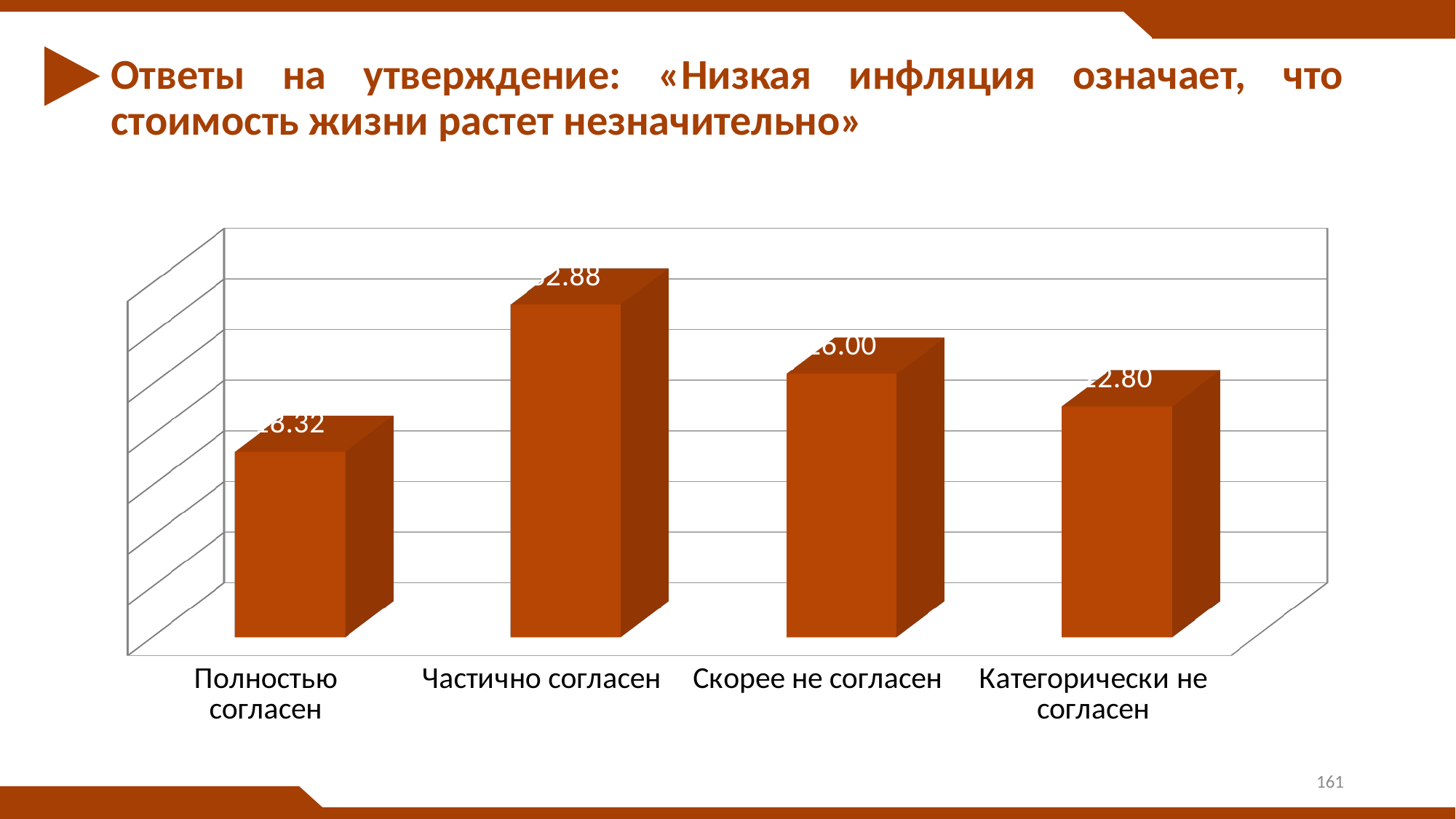
Do the values rise or fall from Полностью согласен to Частично согласен? rise Which response category has the highest value? Частично согласен What colour are the bars in the chart? orange-brown Which is larger: the value for Полностью согласен or the value for Категорически не согласен? Категорически не согласен Which is larger: the value for Частично согласен or the value for Скорее не согласен? Частично согласен How many response categories are shown on the chart? 4 What kind of chart is shown on the slide? bar chart What is the label of the second category on the x axis? Частично согласен Which is larger: the value for Скорее не согласен or the value for Категорически не согласен? Скорее не согласен Which response category has the lowest value? Полностью согласен Do the values rise or fall from Частично согласен to Категорически не согласен along the x axis? fall